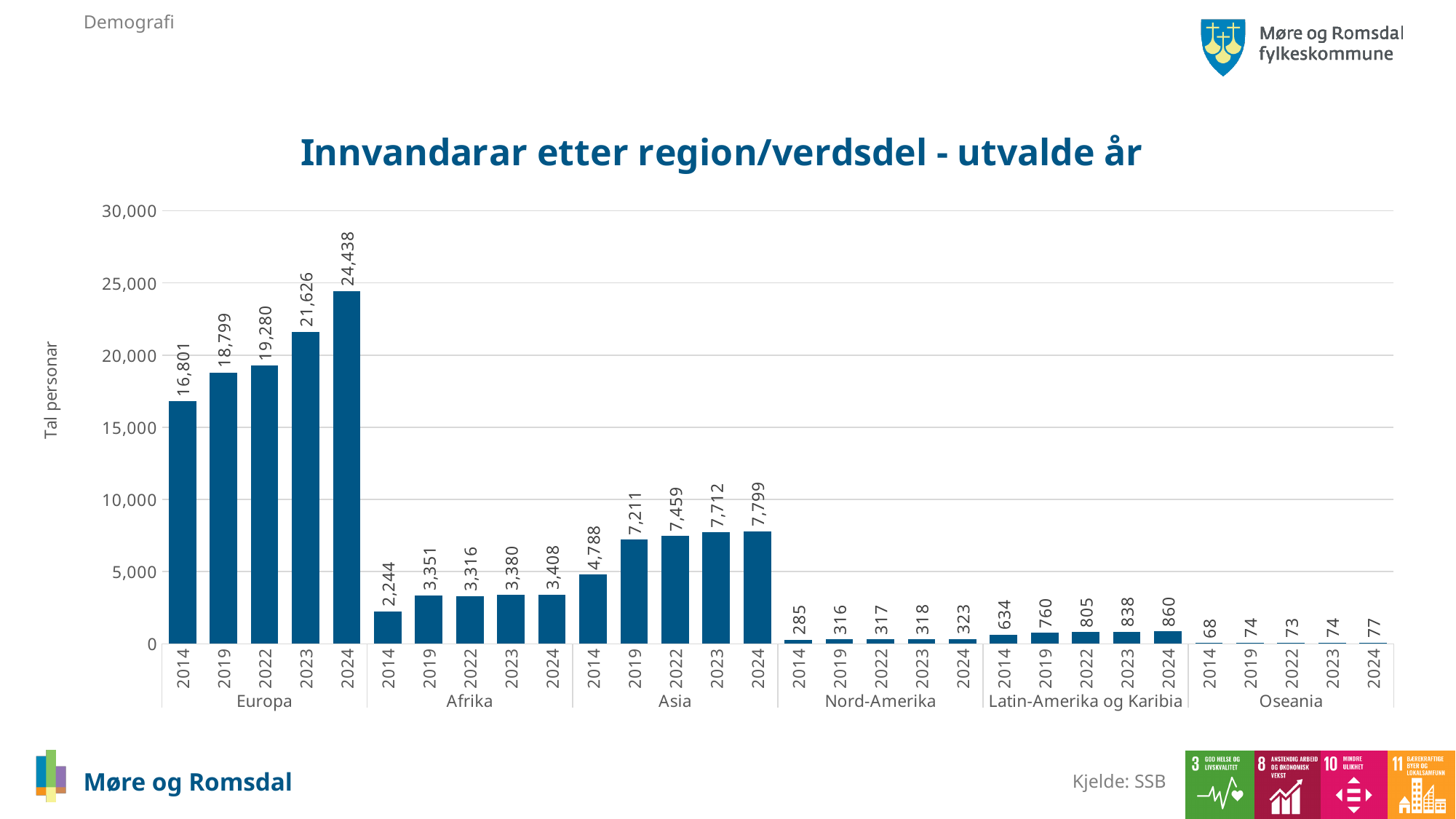
Which is larger: Asia in 2024 or Afrika in 2024? Asia in 2024 What kind of chart is shown on the slide? Bar chart What is the value for Oseania in 2022? 73 Is the value for Europa in 2023 greater or less than 20,000? greater What is the value for Latin-Amerika og Karibia in 2023? 838 Which year has the lowest value within the Afrika group? 2014 What is the value for Europa in 2024? 24,438 Which region has the highest bar on the chart? Europa What is the difference between the Europa values for 2024 and 2014? 7,637 How many regions are shown along the x axis? 6 What is the value for Asia in 2014? 4,788 Do the values for Europa rise or fall from 2014 to 2024? Rise